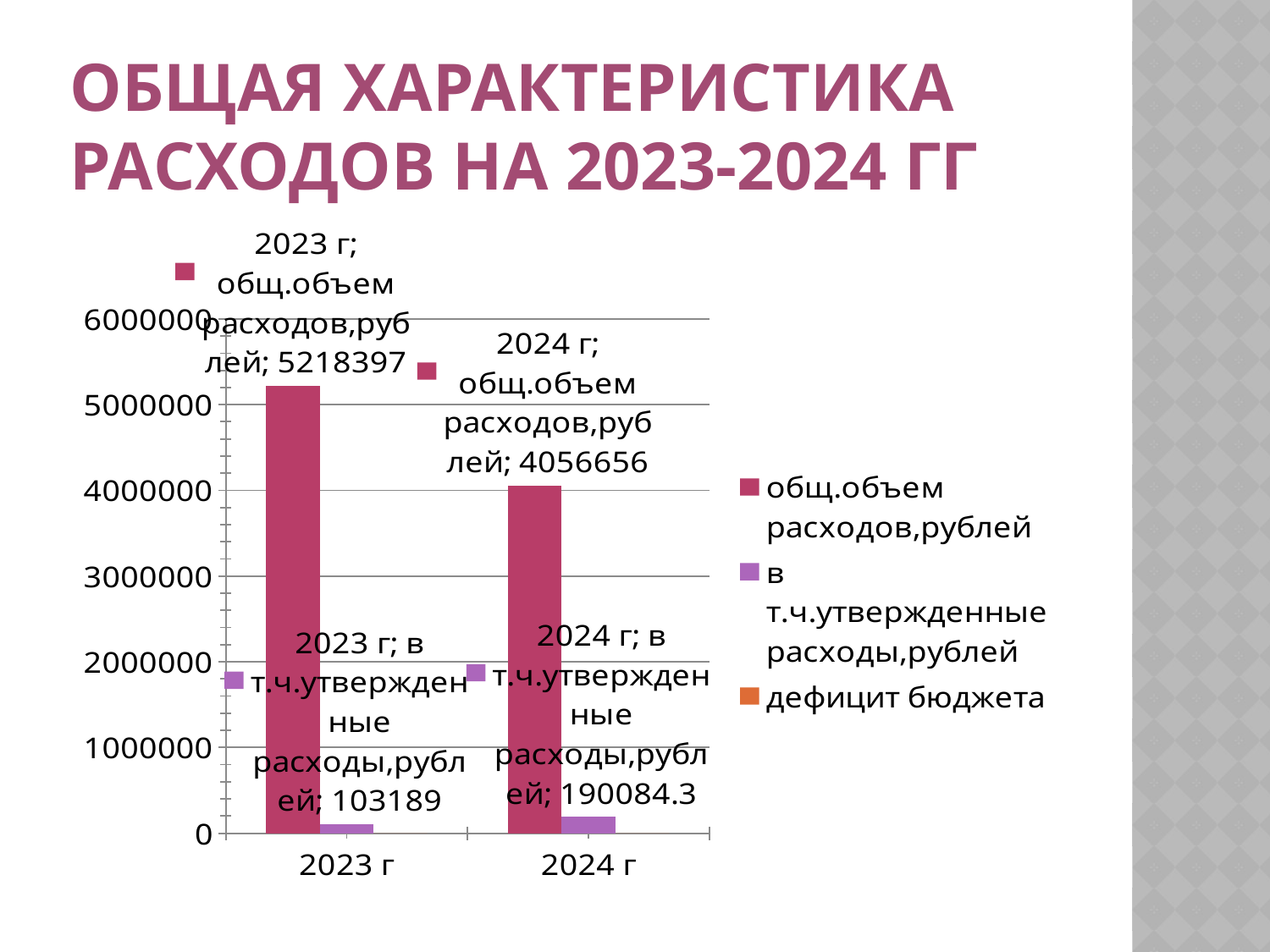
What is the value of в т.ч.утвержденные расходы,рублей for 2023 г? 103189 How many year categories are shown on the x axis? 2 How many series does the legend list? 3 Which year has the lower в т.ч.утвержденные расходы,рублей? 2023 г What kind of chart is shown on the slide? bar chart What is the value of в т.ч.утвержденные расходы,рублей for 2024 г? 190084.3 Which year has the higher общ.объем расходов,рублей? 2023 г What is the value of общ.объем расходов,рублей for 2023 г? 5218397 Is the value of общ.объем расходов,рублей for 2024 г greater or less than 5000000? less What is the value of общ.объем расходов,рублей for 2024 г? 4056656 What is the difference between общ.объем расходов,рублей in 2023 г and 2024 г? 1161741 Is в т.ч.утвержденные расходы,рублей larger in 2023 г or in 2024 г? 2024 г